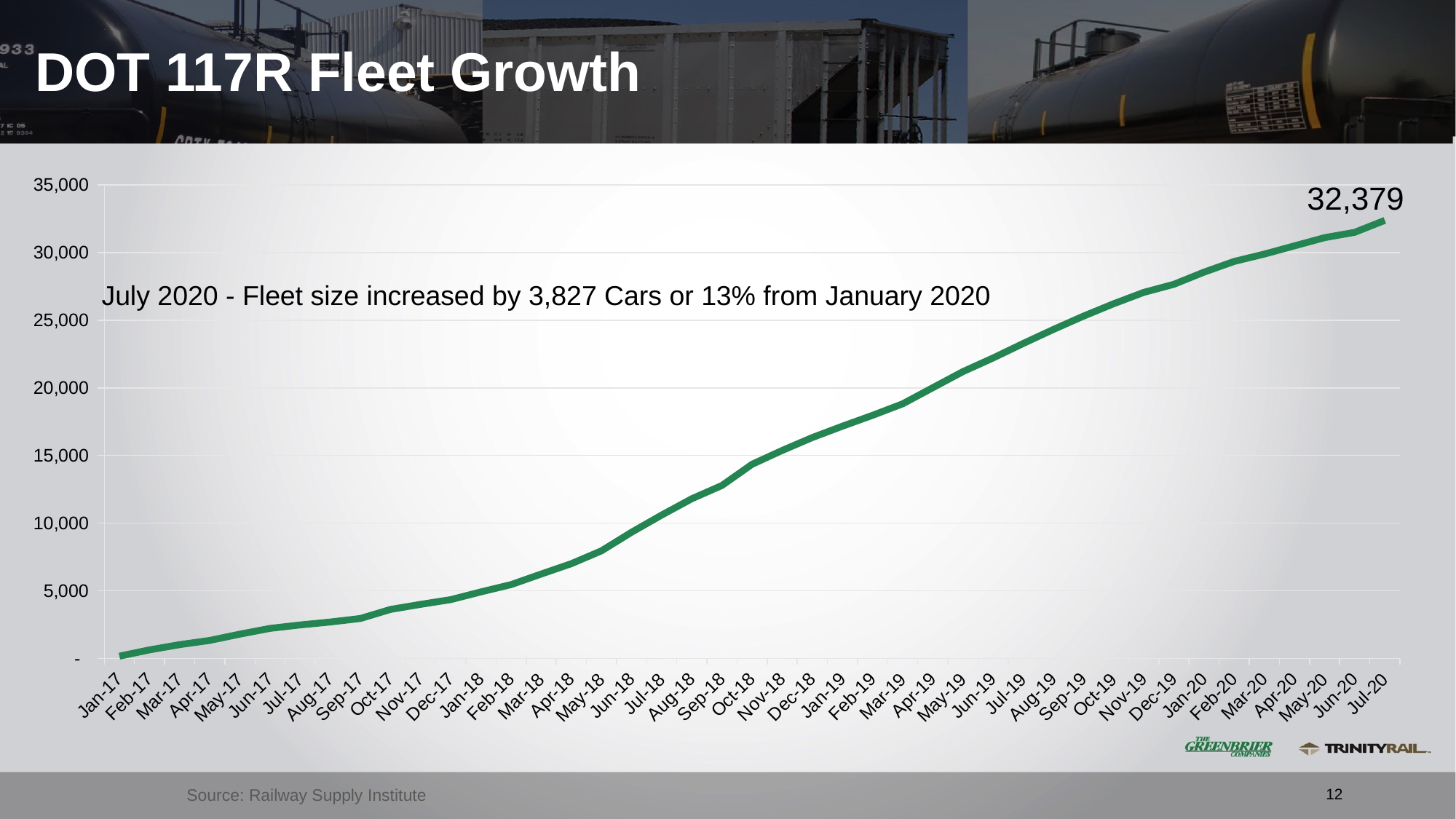
What is the title of the chart on the slide? DOT 117R Fleet Growth How many monthly data points are plotted on the chart? 43 Is the value for Jan-19 greater or less than 15,000? greater Which is larger, the value for Jan-18 or the value for Jan-19? Jan-19 What is the fleet size value labelled at Jul-20? 32,379 Is the value for Jan-17 greater or less than 5,000? less Do the values rise or fall along the x axis from Jan-17 to Jul-20? Rise What colour is the line plotted on the chart? Green Is the value for Jan-20 greater or less than 25,000? greater Which month has the lowest fleet size on the chart? Jan-17 Which month has the highest fleet size on the chart? Jul-20 What type of chart is shown on the slide? Line chart